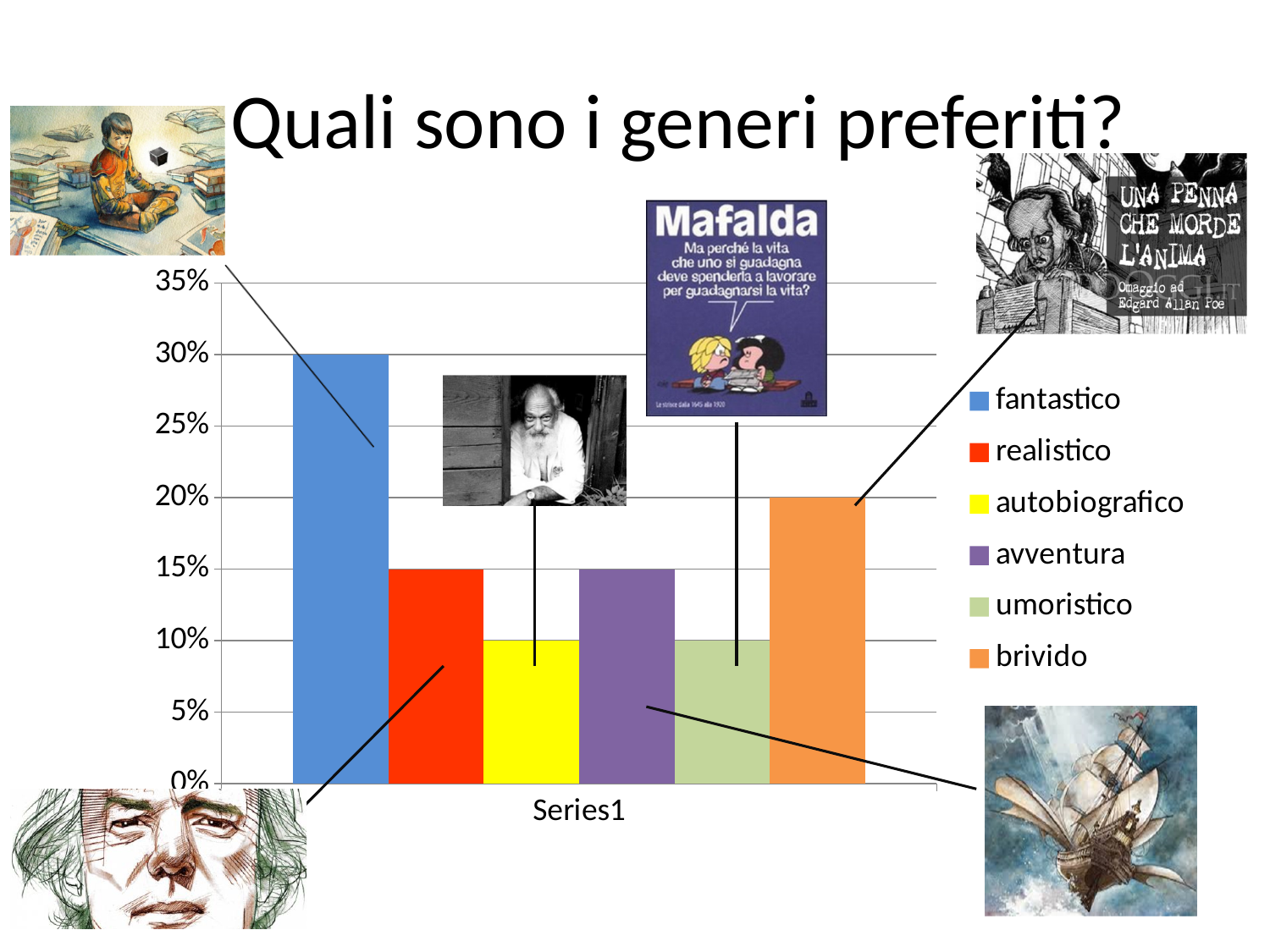
What is the value for brivido? 20% What is the difference between the values for fantastico and brivido? 10% What is the value for realistico? 15% How many entries does the legend list? 6 What is the title of the slide containing the chart? Quali sono i generi preferiti? What kind of chart is shown on the slide? bar chart Is the value for avventura greater or less than 10%? greater Which genre has the highest value? fantastico What is the value for umoristico? 10% Which is larger, the value for realistico or the value for autobiografico? realistico How many bars are plotted in the chart? 6 What is the value for fantastico? 30%